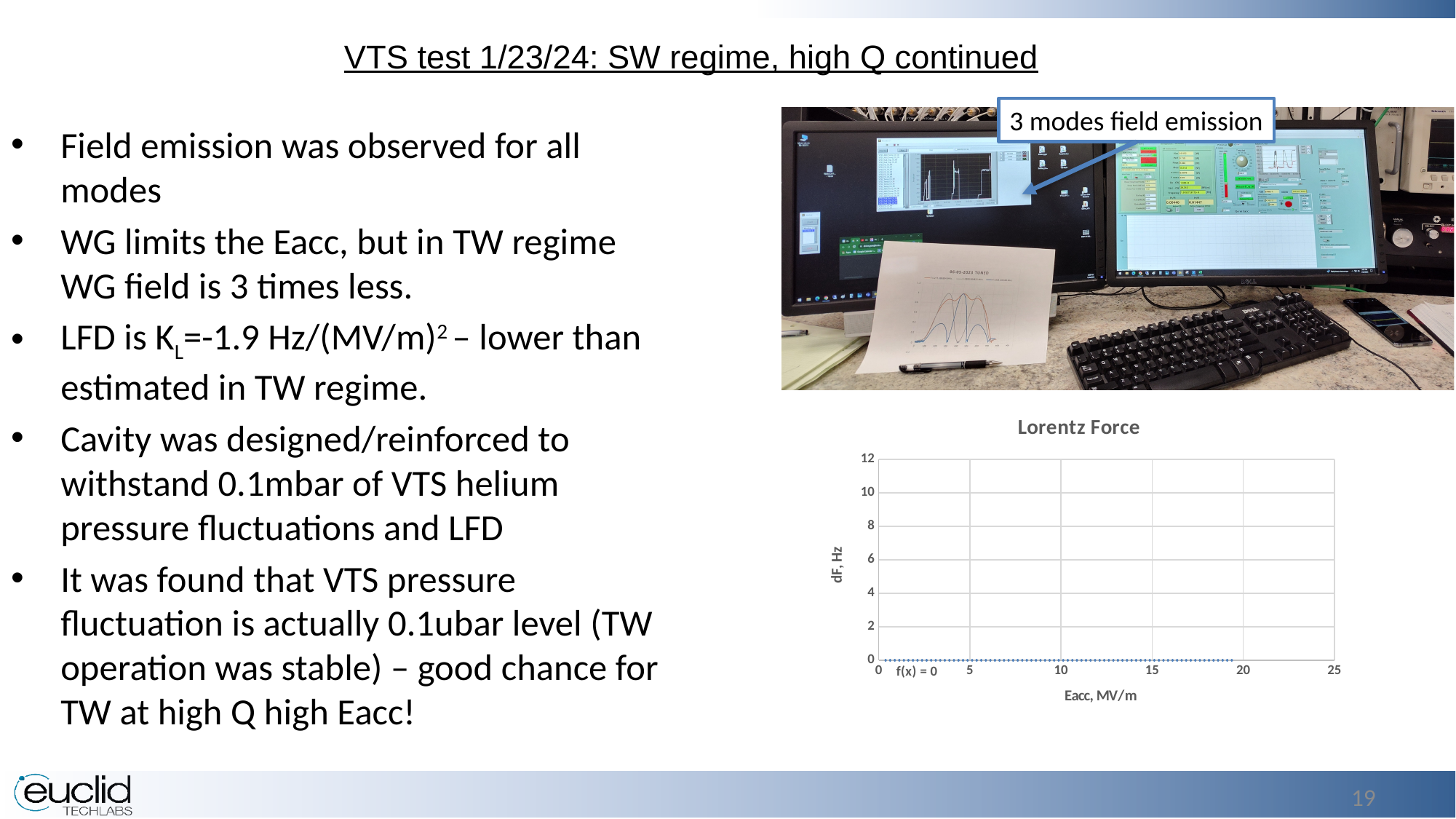
What is the title of the chart on the slide? Lorentz Force What is the highest tick value shown on the x axis of the Lorentz Force chart? 25 What fitted function equation is printed on the Lorentz Force chart? f(x) = 0 In the Lorentz Force chart, is the plotted dF value at Eacc = 15 MV/m greater or less than 6 Hz? less What is the highest tick value shown on the y axis of the Lorentz Force chart? 12 What kind of chart is the Lorentz Force chart? scatter chart In the Lorentz Force chart, is the plotted dF value at Eacc = 10 MV/m greater or less than 2 Hz? less What is the label of the x axis of the Lorentz Force chart? Eacc, MV/m What is the label of the y axis of the Lorentz Force chart? dF, Hz